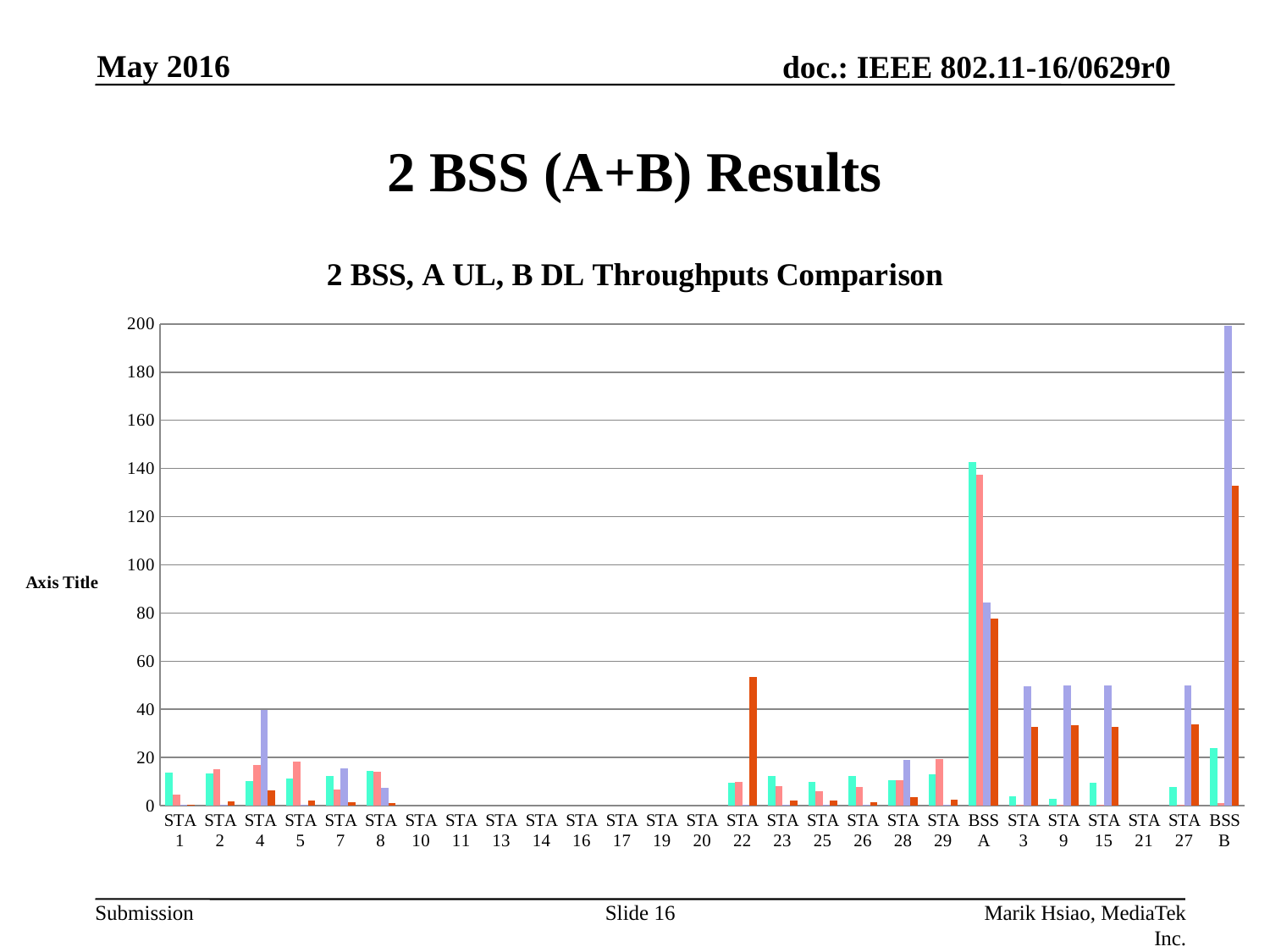
What kind of chart is shown on the slide? bar chart Which category has the taller maximum bar, BSS A or BSS B? BSS B Is the tallest bar for STA 22 greater or less than 40? greater What is the title of the chart? 2 BSS, A UL, B DL Throughputs Comparison Is the tallest bar for BSS B greater or less than 180? greater Which category has the taller maximum bar, STA 22 or STA 23? STA 22 Is the tallest bar for STA 1 greater or less than 20? less How many bars are plotted for each category in the chart? 4 What is the label shown on the vertical axis of the chart? Axis Title Which category has the tallest bar in the chart? BSS B How many categories are shown along the x axis of the chart? 27